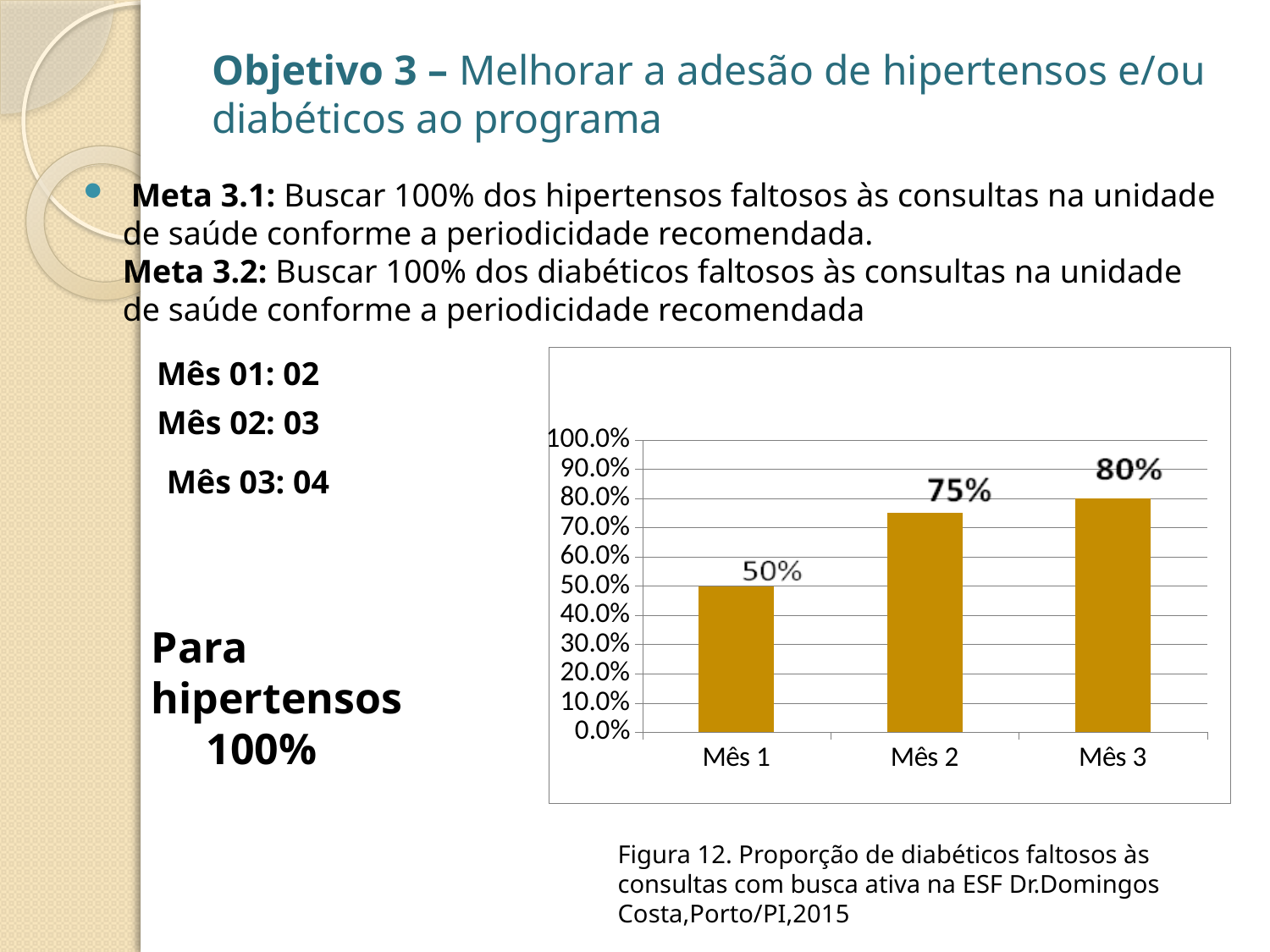
Which month has the highest value? Mês 3 How many months are shown on the x axis? 3 Do the values rise or fall from Mês 1 to Mês 3? rise Which is larger, the value for Mês 1 or the value for Mês 2? Mês 2 What is the difference between the values for Mês 3 and Mês 2? 5% What is the value for Mês 3? 80% What is the difference between the values for Mês 2 and Mês 1? 25% What kind of chart is shown? bar chart What is the value for Mês 2? 75% Which month has the lowest value? Mês 1 What is the value for Mês 1? 50% Is the value for Mês 3 greater or less than 70.0%? greater